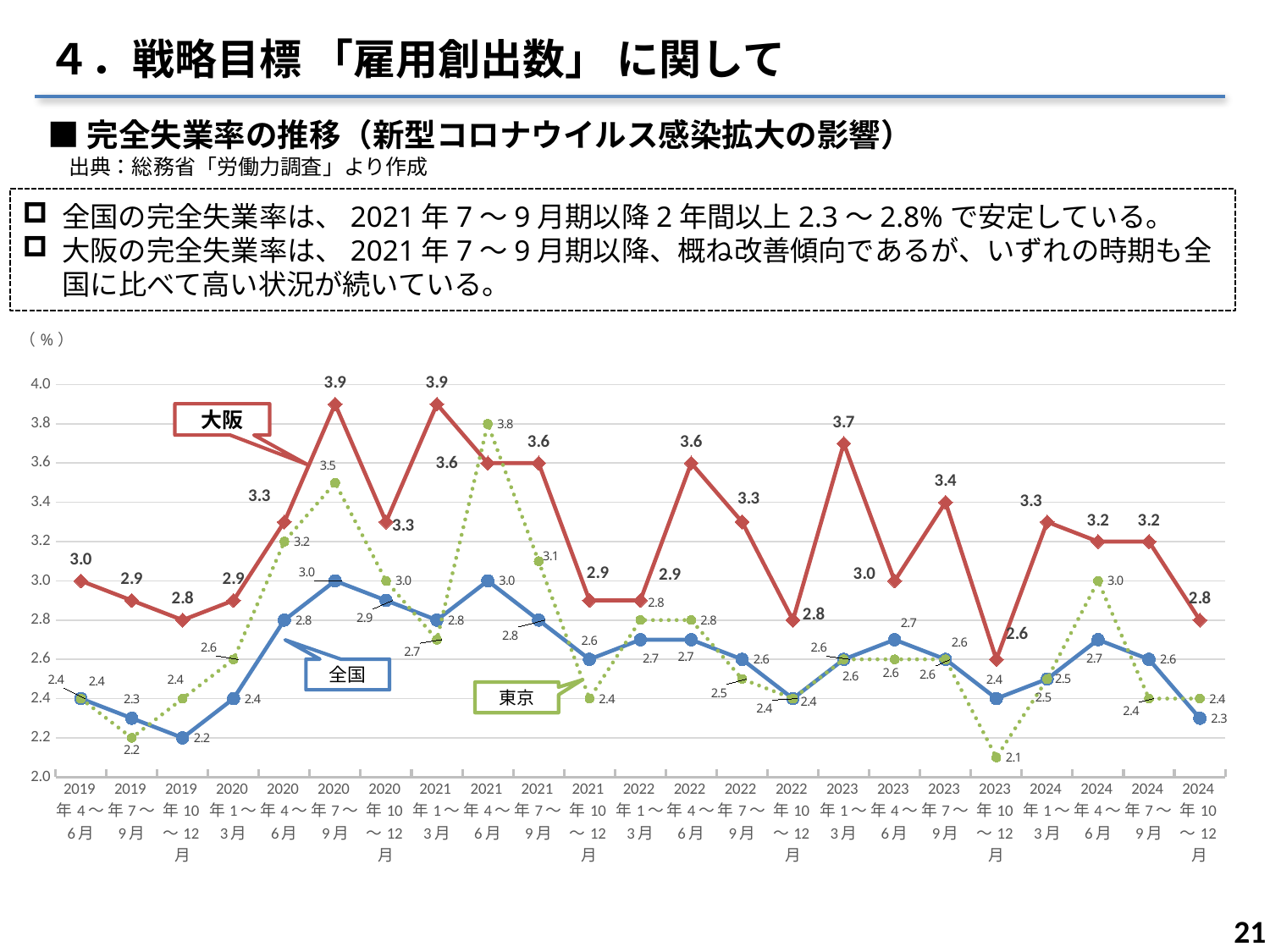
In 2021年4〜6月, which is higher, 大阪 or 東京? 東京 What is the value for 全国 in 2024年10〜12月? 2.3 In which period does 東京 reach its lowest value? 2023年10〜12月 What is the highest value plotted for 大阪? 3.9 Is the value for 大阪 in 2023年10〜12月 greater or less than 3.0? less What is the difference between 大阪 and 全国 in 2023年1〜3月? 1.1 What is the value for 大阪 in 2020年7〜9月? 3.9 How many series are plotted in the chart? 3 How many periods are shown on the x axis? 23 What is the value for 東京 in 2021年4〜6月? 3.8 Do the values for 大阪 rise or fall from 2024年1〜3月 to 2024年10〜12月? fall What kind of chart is shown on the slide? line chart